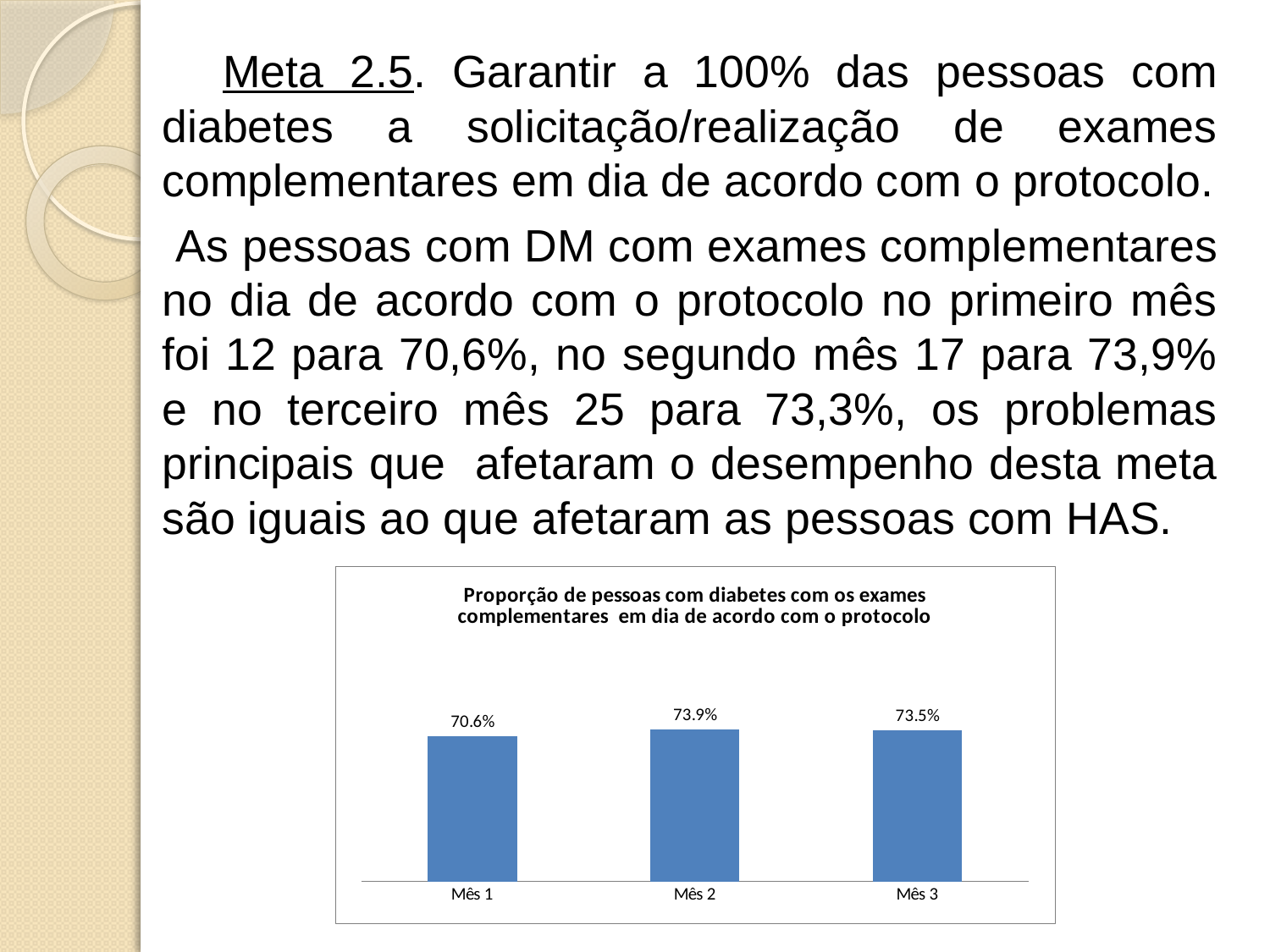
What is the value for Mês 1 in the chart? 70.6% What kind of chart is shown on the slide? Bar chart How many months (categories) are shown in the chart? 3 What is the difference between the values for Mês 2 and Mês 1? 3.3% What is the value for Mês 2 in the chart? 73.9% What is the value for Mês 3 in the chart? 73.5% What is the title of the chart? Proporção de pessoas com diabetes com os exames complementares em dia de acordo com o protocolo Which month has the highest value in the chart? Mês 2 Which month has the lowest value in the chart? Mês 1 What is the difference between the values for Mês 3 and Mês 1? 2.9% Which is larger, the value for Mês 1 or the value for Mês 3? Mês 3 Does the value rise or fall from Mês 1 to Mês 2? Rise